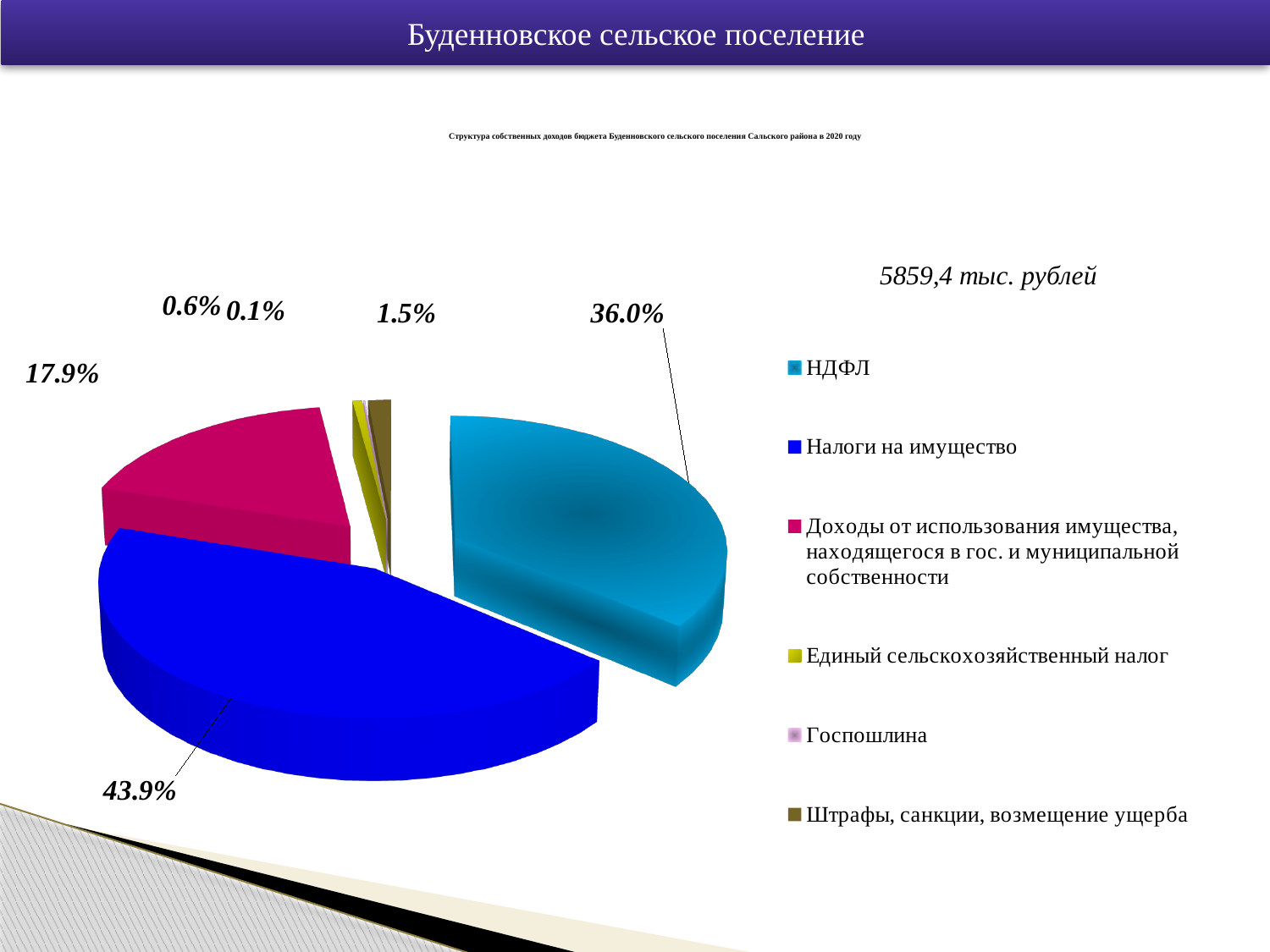
What is the difference between the share for НДФЛ and the share for Доходы от использования имущества, находящегося в гос. и муниципальной собственности? 18.1% What share of the pie does Доходы от использования имущества, находящегося в гос. и муниципальной собственности have? 17.9% Which category has the smallest slice of the pie? Госпошлина What is the difference between the share for Налоги на имущество and the share for НДФЛ? 7.9% How many categories does the legend list? 6 Which is larger: the share for НДФЛ or the share for Налоги на имущество? Налоги на имущество Which category has the largest slice of the pie? Налоги на имущество What share of the pie does Налоги на имущество have? 43.9% What total amount in thousand rubles is shown next to the chart? 5859,4 тыс. рублей What colour is the slice for Налоги на имущество? blue What kind of chart is shown on the slide? pie chart What share of the pie does НДФЛ have? 36.0%